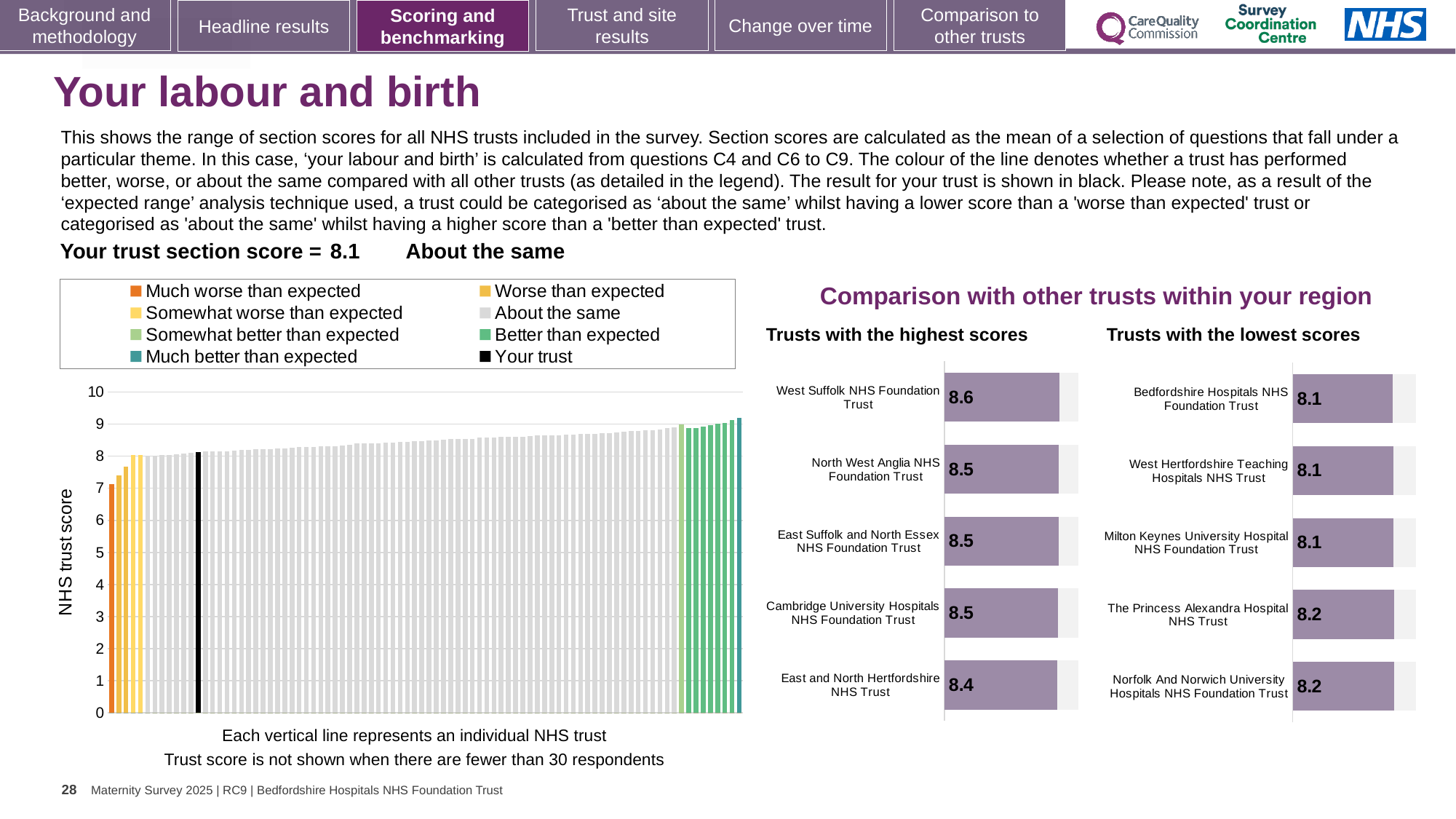
What is the y-axis label of the large chart on the left? NHS trust score In the large chart on the left, do the trust scores rise or fall from left to right? Rise In the 'Trusts with the highest scores' chart, what is the score for West Suffolk NHS Foundation Trust? 8.6 In the 'Trusts with the lowest scores' chart, what is the score for Milton Keynes University Hospital NHS Foundation Trust? 8.1 In the 'Trusts with the highest scores' chart, what is the difference between the scores of West Suffolk NHS Foundation Trust and East and North Hertfordshire NHS Trust? 0.2 How many entries does the legend of the large chart on the left list? 8 Which is larger: the score for West Suffolk NHS Foundation Trust in the 'Trusts with the highest scores' chart or the score for Norfolk And Norwich University Hospitals NHS Foundation Trust in the 'Trusts with the lowest scores' chart? West Suffolk NHS Foundation Trust In the 'Trusts with the highest scores' chart, which trust has the lowest score? East and North Hertfordshire NHS Trust In the 'Trusts with the highest scores' chart, which trust has the highest score? West Suffolk NHS Foundation Trust What kind of chart is the large chart on the left showing NHS trust scores? Bar chart How many trusts are shown in the 'Trusts with the lowest scores' chart? 5 In the 'Trusts with the lowest scores' chart, what is the score for The Princess Alexandra Hospital NHS Trust? 8.2